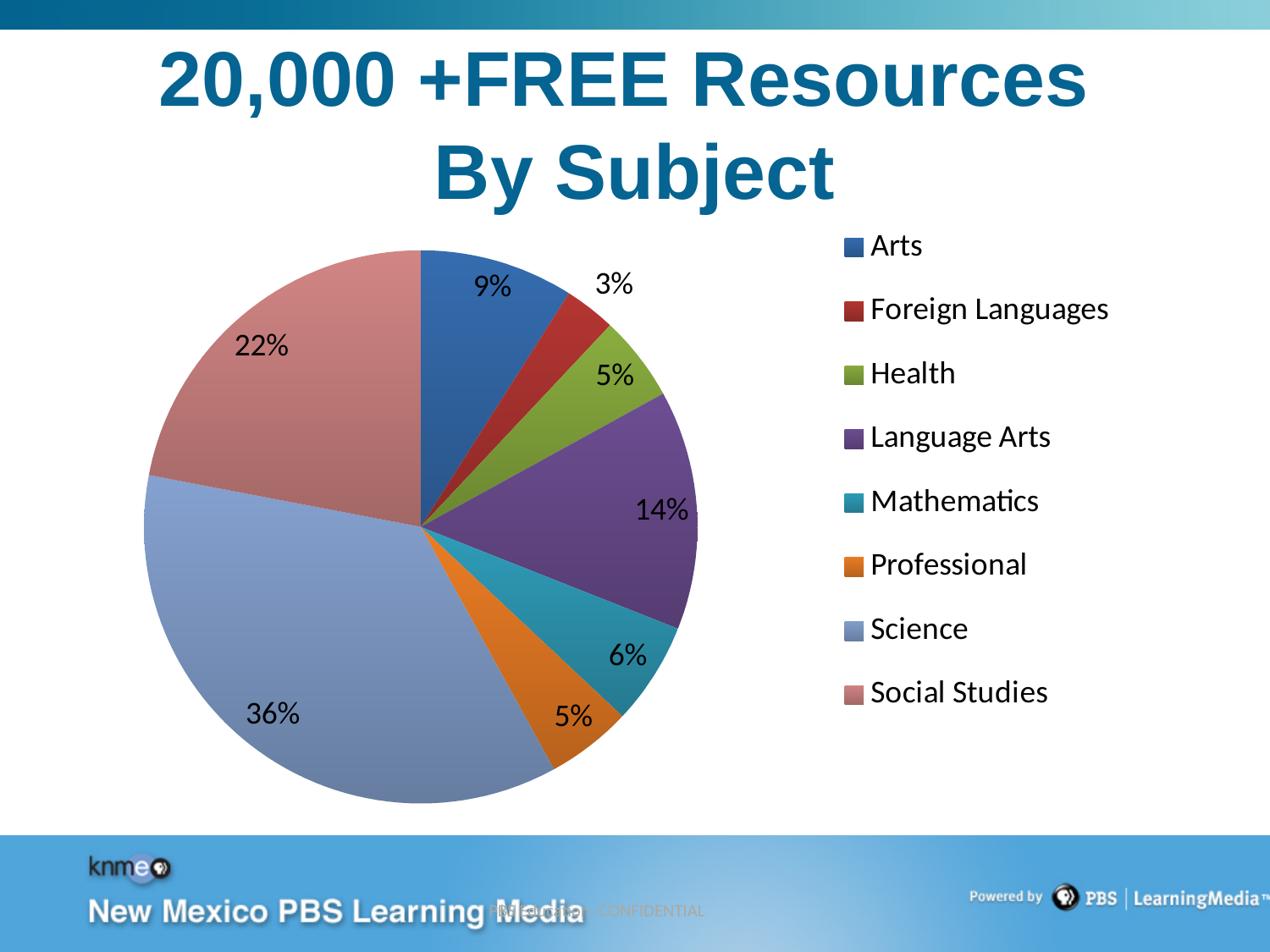
What is the difference in percentage points between Science and Social Studies? 14 What is the difference in percentage points between Language Arts and Mathematics? 8 How many subject categories does the legend list? 8 Which subject has the largest slice of the pie? Science Which is larger, the share for Mathematics or the share for Arts? Arts What percentage is shown for Social Studies? 22% What share of the pie does Science account for? 36% What kind of chart is shown on the slide? pie chart What percentage is shown for Arts? 9% What percentage is shown for Language Arts? 14% Which subject has the smallest slice of the pie? Foreign Languages What is the title of the slide containing the chart? 20,000 +FREE Resources By Subject